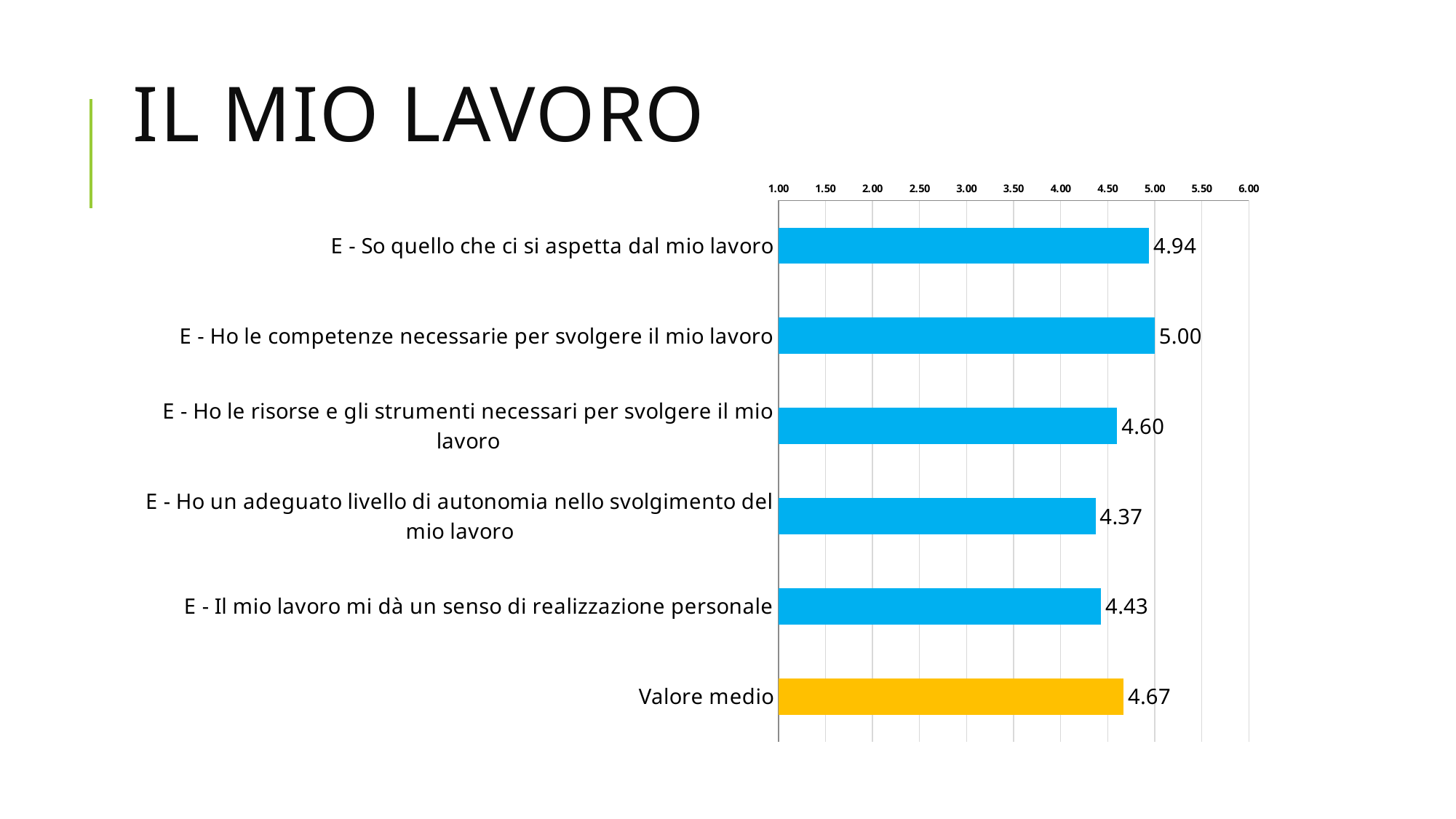
Which category has the lowest value? E - Ho un adeguato livello di autonomia nello svolgimento del mio lavoro What is the difference between the values for "E - Ho le competenze necessarie per svolgere il mio lavoro" and "E - Ho le risorse e gli strumenti necessari per svolgere il mio lavoro"? 0.40 Which bar is coloured differently (yellow) from the others? Valore medio How many bars are shown in the chart? 6 What is the title of the slide? IL MIO LAVORO Is the value for "E - Ho le risorse e gli strumenti necessari per svolgere il mio lavoro" greater or less than 4.50? greater Which category has the highest value? E - Ho le competenze necessarie per svolgere il mio lavoro What is the value for "E - Ho un adeguato livello di autonomia nello svolgimento del mio lavoro"? 4.37 What is the value for "E - So quello che ci si aspetta dal mio lavoro"? 4.94 What kind of chart is shown on the slide? bar chart What is the value of the "Valore medio" bar? 4.67 Which is larger: the value for "E - Il mio lavoro mi dà un senso di realizzazione personale" or the value for "E - Ho un adeguato livello di autonomia nello svolgimento del mio lavoro"? E - Il mio lavoro mi dà un senso di realizzazione personale